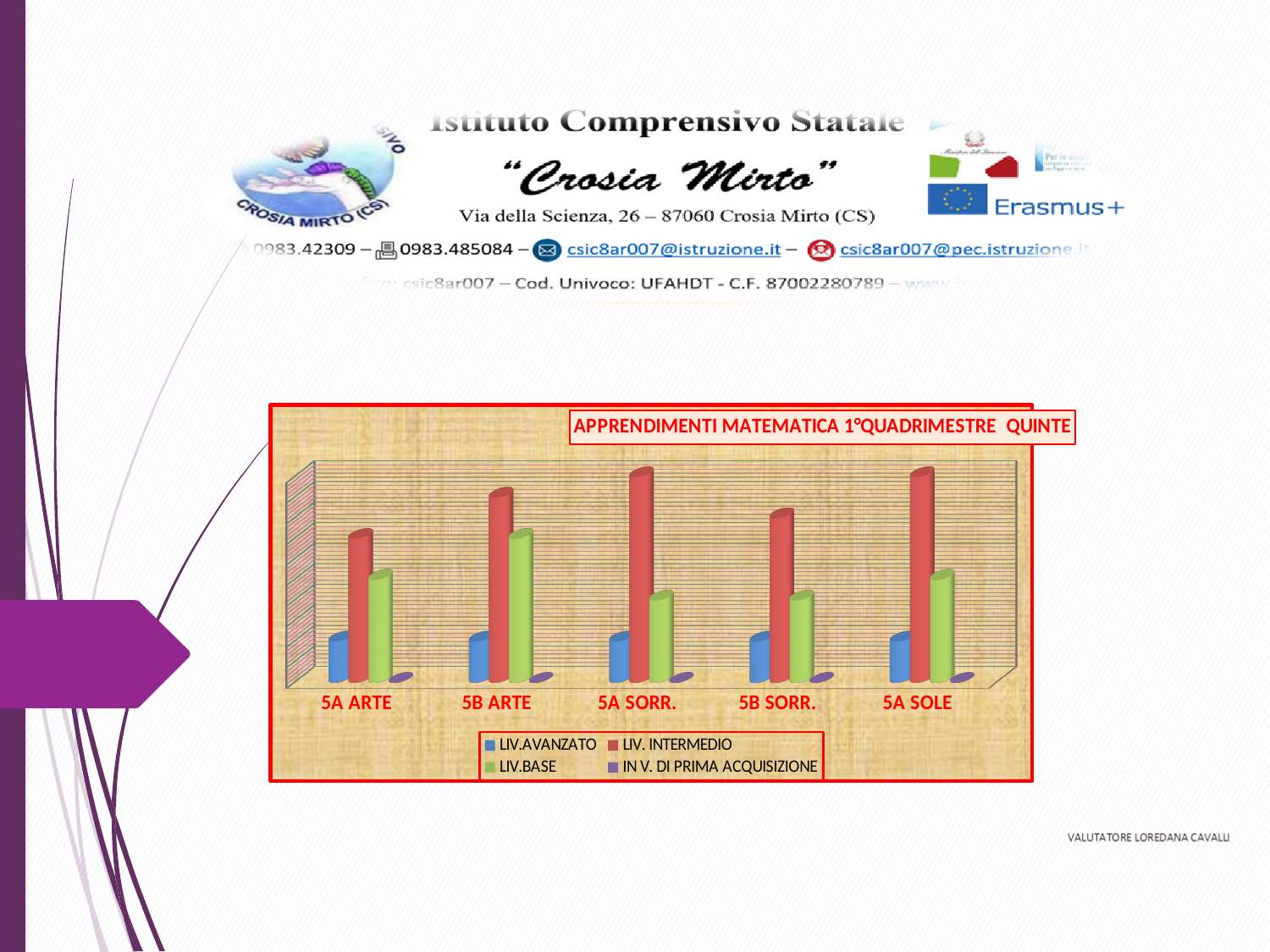
Which class has the lowest LIV. INTERMEDIO bar? 5A ARTE Which class has the highest LIV.BASE bar? 5B ARTE Which is larger for 5A SORR.: LIV.BASE or LIV.AVANZATO? LIV.BASE How many classes (categories) are shown on the x axis of the chart? 5 Which series has the smallest bar in every class shown in the chart? IN V. DI PRIMA ACQUISIZIONE Which series is shown in red in the chart? LIV. INTERMEDIO How many series does the chart legend list? 4 Which series has the tallest bar in every class shown in the chart? LIV. INTERMEDIO For 5B ARTE, which is larger: LIV. INTERMEDIO or LIV.BASE? LIV. INTERMEDIO What is the title of the chart? APPRENDIMENTI MATEMATICA 1°QUADRIMESTRE QUINTE What kind of chart is shown on the slide? Bar chart For 5A ARTE, which is larger: LIV.BASE or LIV.AVANZATO? LIV.BASE